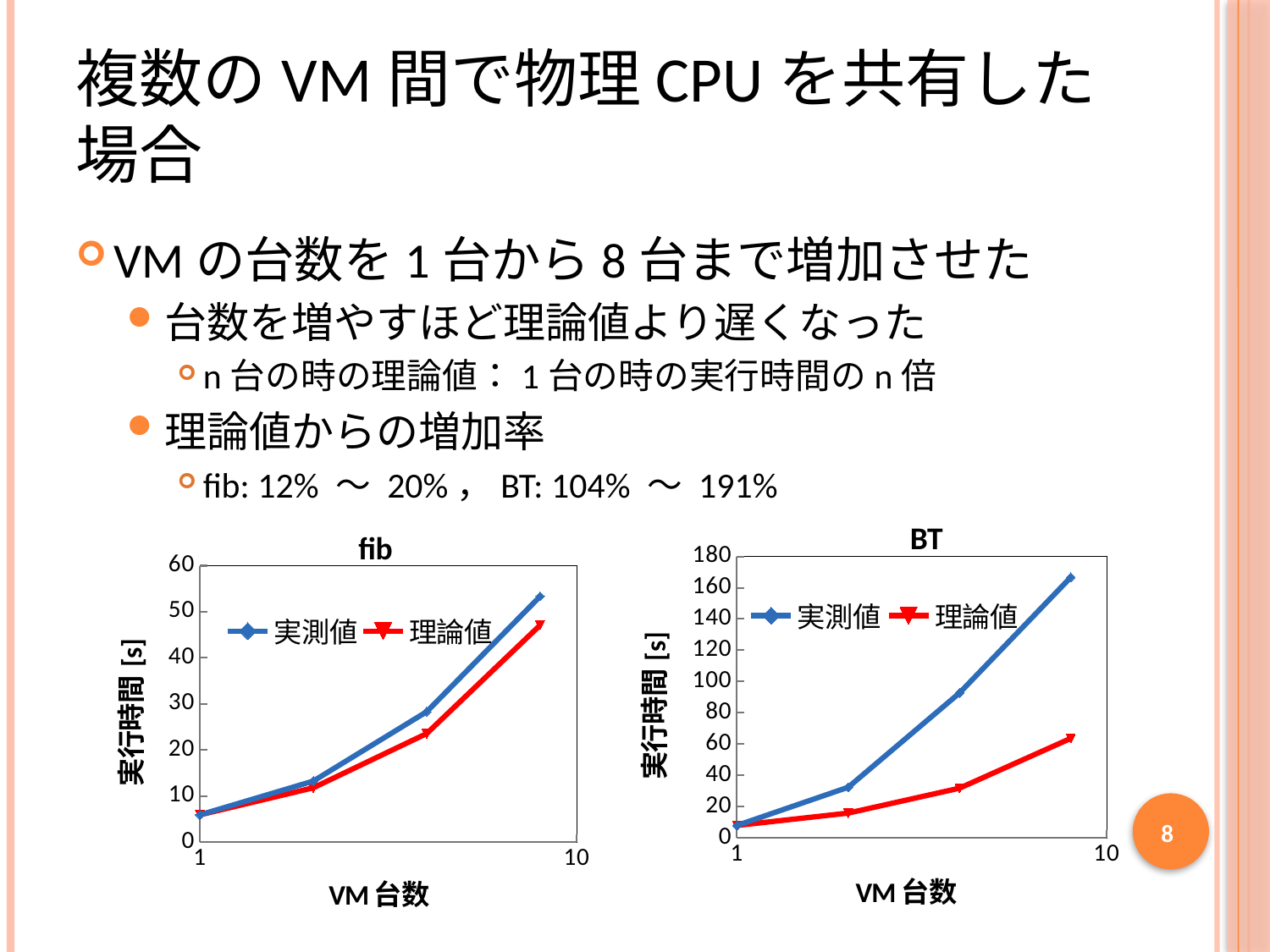
In the BT chart, how many series does the legend list? 2 In the BT chart, is the 理論値 value at 4 VMs greater or less than 40? less In the BT chart, is the 実測値 value at the rightmost point (8 VMs) greater or less than 160? greater In the BT chart, do the 実測値 values rise or fall as the number of VMs increases? rise In the fib chart, how many data points does the 実測値 series have? 4 In the fib chart, what kind of chart is shown? line chart In the fib chart, is the 実測値 value at the rightmost point (8 VMs) greater or less than 50? greater In the BT chart, which series has the larger value at the rightmost point (8 VMs), 実測値 or 理論値? 実測値 What is the y-axis label of the fib chart? 実行時間 [s] In the fib chart, which colour is used for the 理論値 series? red